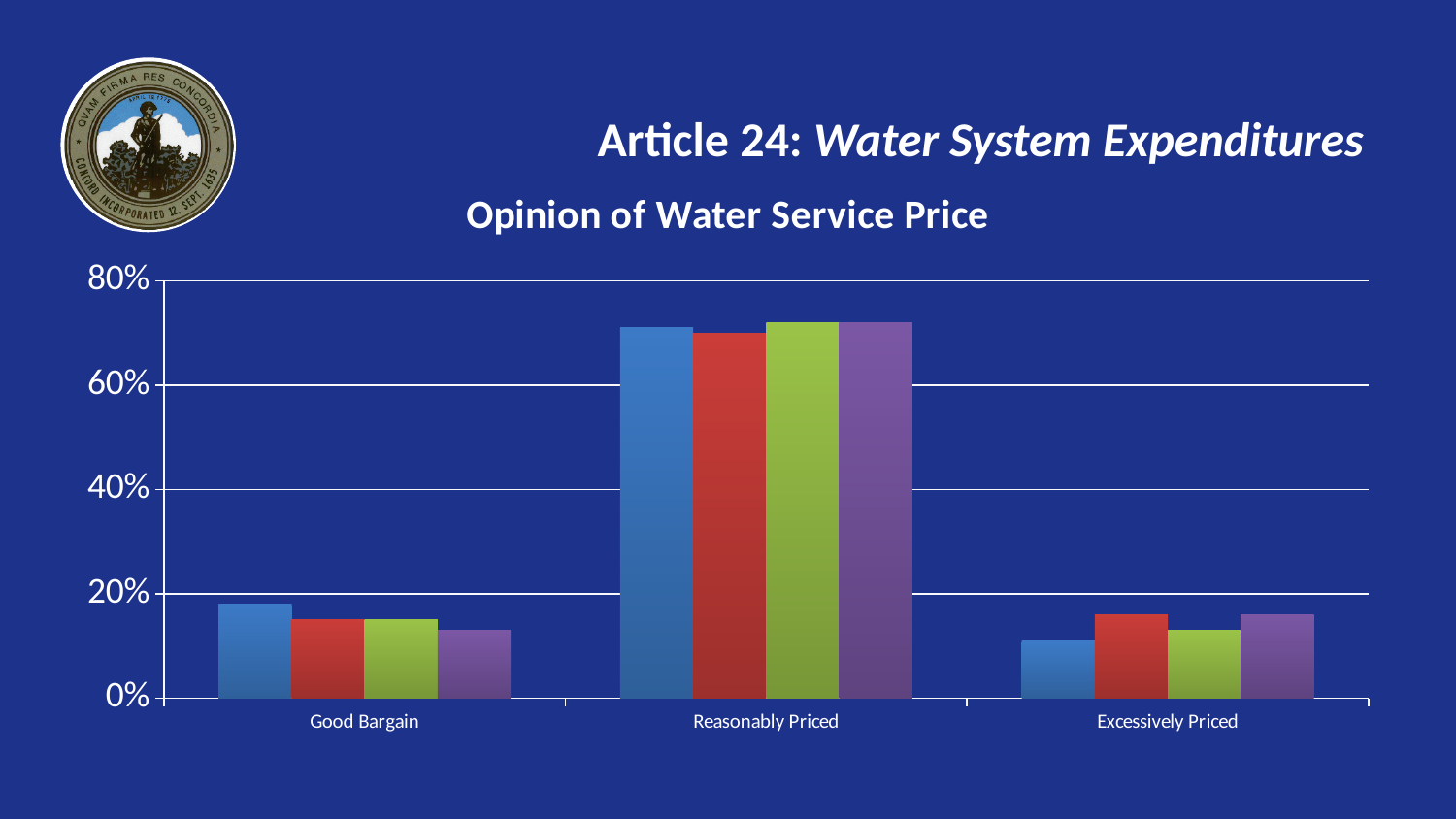
Which is larger, the red bar for Reasonably Priced or the red bar for Excessively Priced? Reasonably Priced Which category has the highest bars in the chart? Reasonably Priced How many categories are shown on the x axis of the chart? 3 Is the blue bar for Good Bargain greater or less than 40%? less What is the title of the chart? Opinion of Water Service Price How many bars are plotted for each category in the chart? 4 Which is larger, the blue bar for Good Bargain or the blue bar for Excessively Priced? Good Bargain Are the values for Reasonably Priced greater or less than 60%? greater Are the values for Excessively Priced greater or less than 20%? less What kind of chart is shown on the slide? bar chart What is the highest value shown on the y axis of the chart? 80%